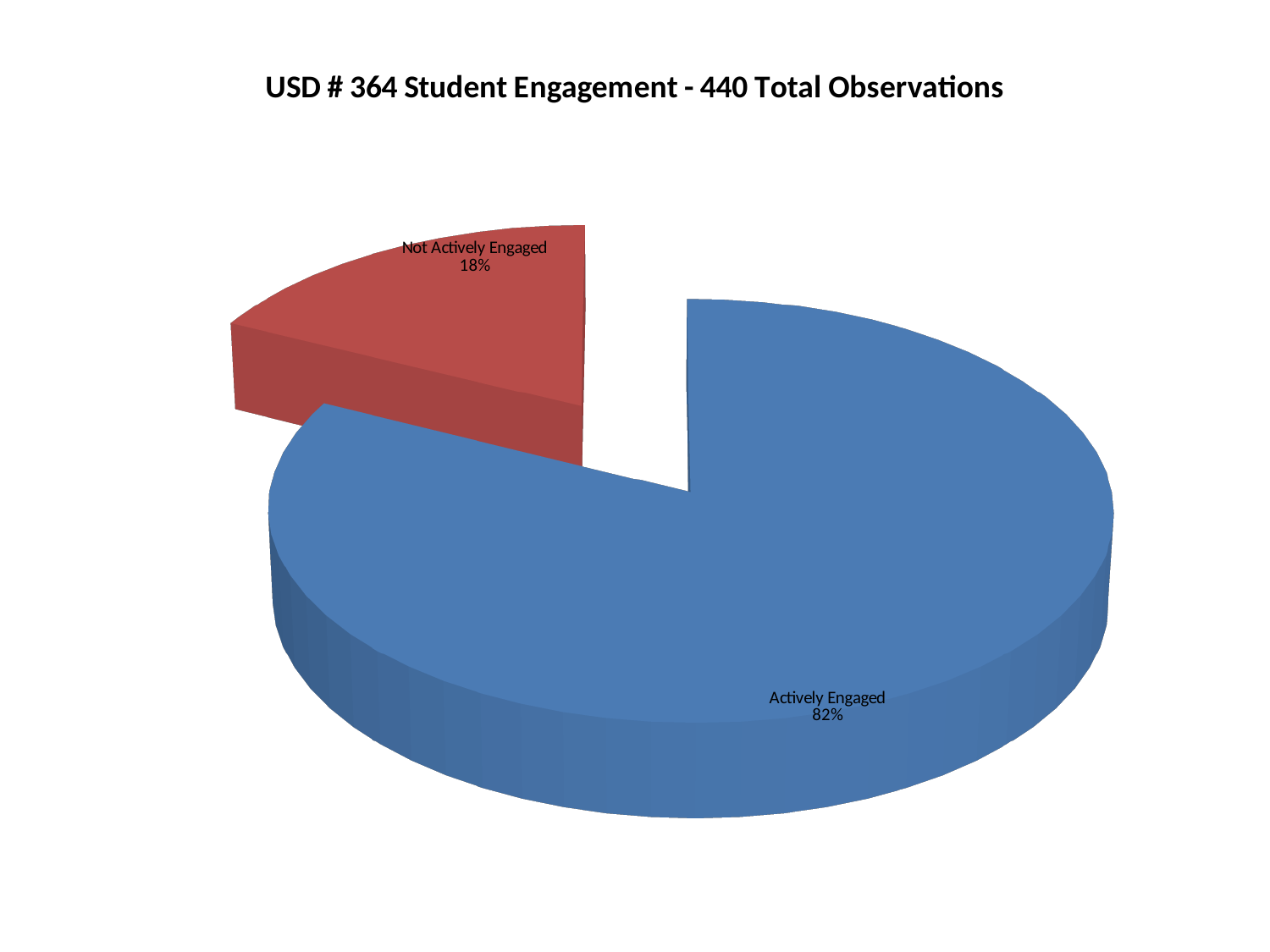
What colour is the Not Actively Engaged slice? Red What is the difference in percentage points between the Actively Engaged and Not Actively Engaged slices? 64 percentage points Which is larger, the Actively Engaged slice or the Not Actively Engaged slice? Actively Engaged How many total observations does the chart title state? 440 What share of the pie is labelled Not Actively Engaged? 18% What share of the pie is labelled Actively Engaged? 82% Which slice of the pie is the smallest? Not Actively Engaged How many slices does the pie chart have? 2 Which slice of the pie is the largest? Actively Engaged What kind of chart is shown on the slide? Pie chart What is the title of the chart? USD # 364 Student Engagement - 440 Total Observations